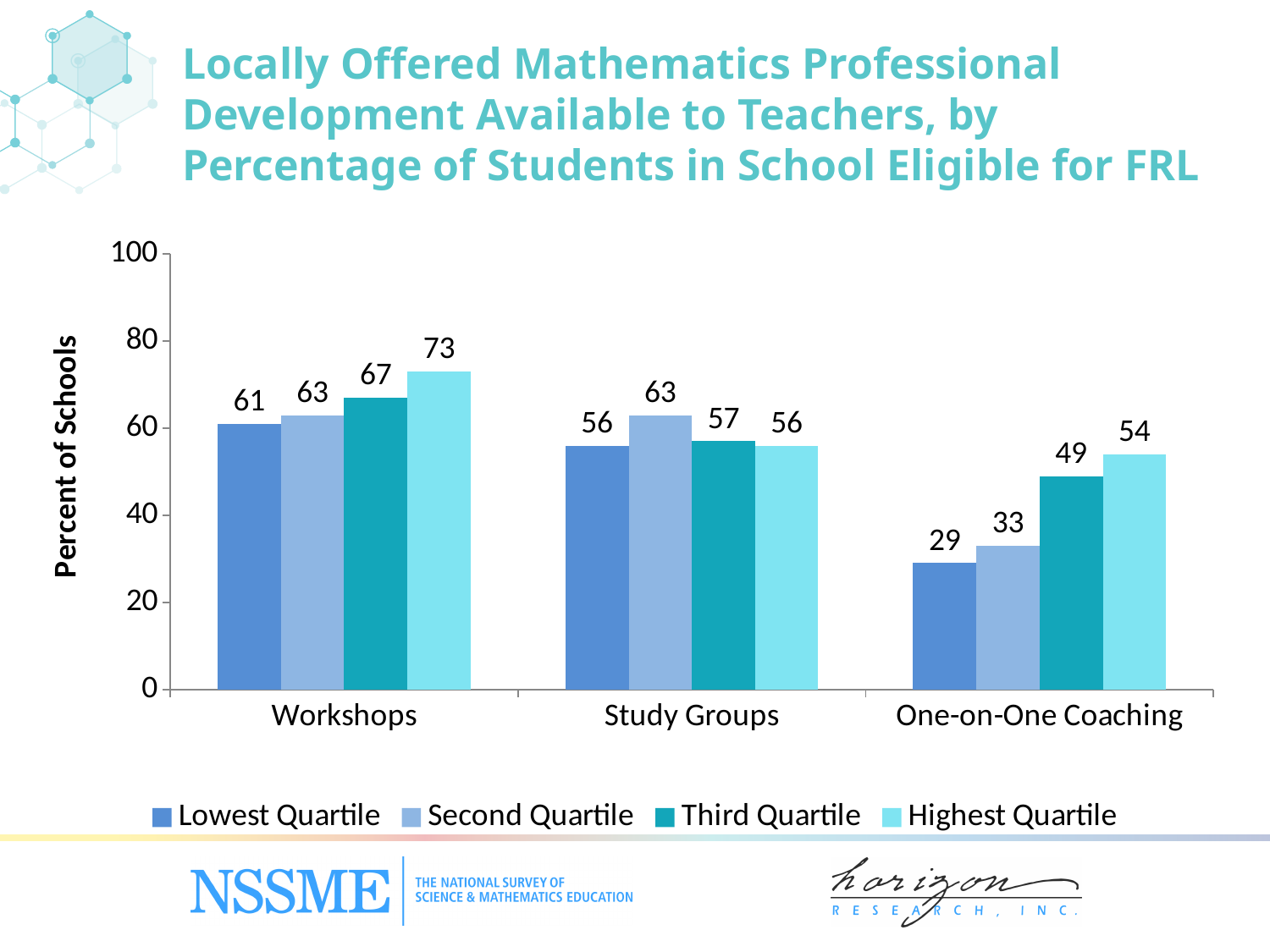
What kind of chart is shown on the slide? Bar chart What is the value for the Second Quartile in the Study Groups category? 63 Which is larger: the Second Quartile value for Workshops or the Second Quartile value for One-on-One Coaching? Workshops What is the label of the y axis? Percent of Schools How many series does the legend list? 4 What is the value for the Highest Quartile in the Workshops category? 73 What is the difference between the Highest Quartile and Lowest Quartile values for One-on-One Coaching? 25 What is the value for the Lowest Quartile in the One-on-One Coaching category? 29 Which category has the lowest value for the Highest Quartile series? One-on-One Coaching Which category has the highest value for the Third Quartile series? Workshops Is the value for the Third Quartile in One-on-One Coaching greater or less than 40? greater How many categories are shown on the x axis? 3